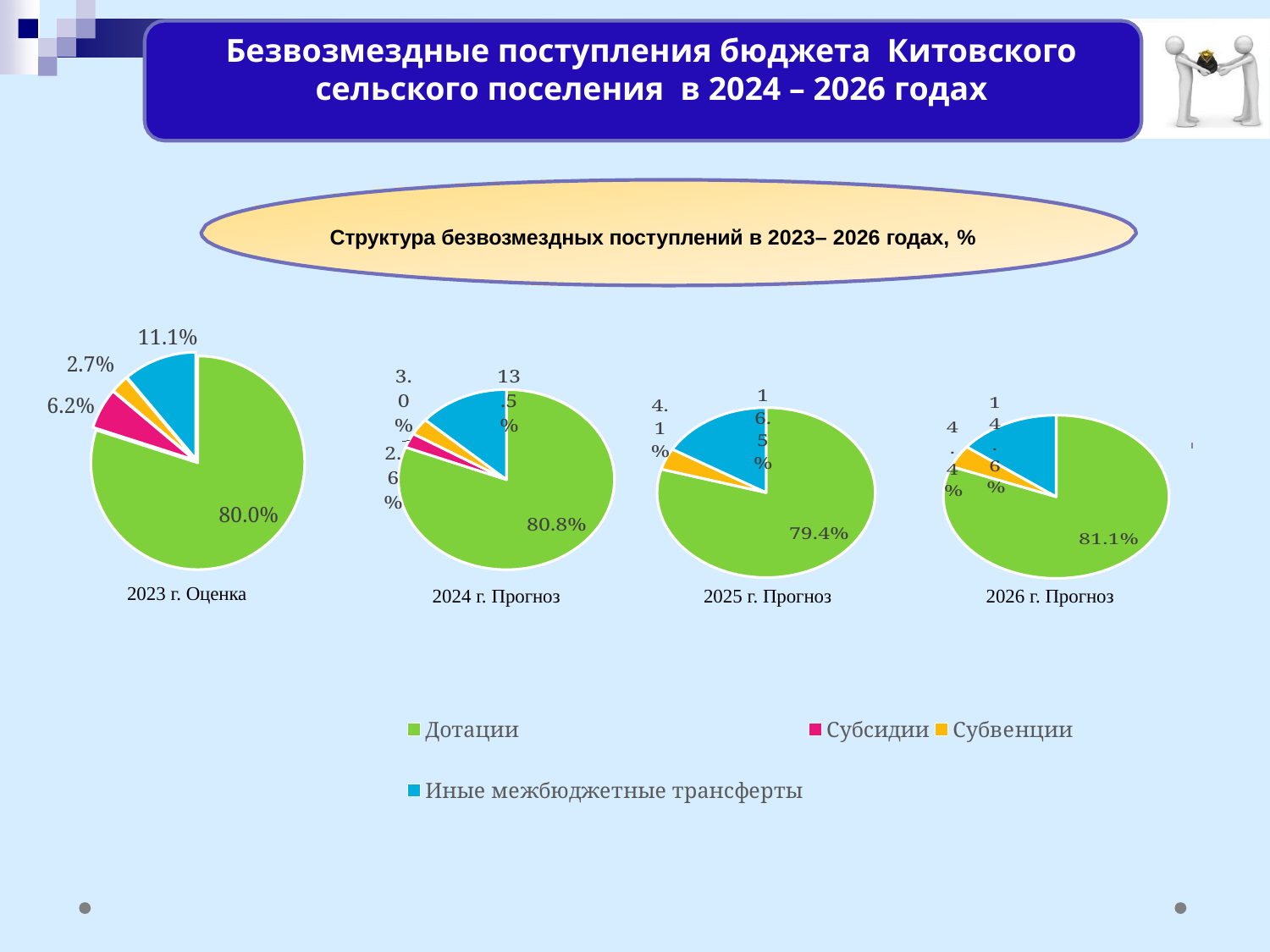
In the 2026 г. Прогноз pie chart, what is the value for Дотации? 81.1% In the 2023 г. Оценка pie chart, which category has the smallest share? Субвенции In the 2023 г. Оценка pie chart, which category has the largest share? Дотации In the 2023 г. Оценка pie chart, what is the value for Иные межбюджетные трансферты? 11.1% In the 2023 г. Оценка pie chart, what is the value for Субсидии? 6.2% In the 2024 г. Прогноз pie chart, what is the value for Дотации? 80.8% In the 2023 г. Оценка pie chart, what is the value for Дотации? 80.0% In the 2025 г. Прогноз pie chart, what is the value for Дотации? 79.4% How many series does the legend list for the charts on this slide? 4 Which is larger: the Дотации share in the 2025 г. Прогноз chart or in the 2026 г. Прогноз chart? 2026 г. Прогноз In the 2023 г. Оценка pie chart, what is the difference between the Дотации share and the Иные межбюджетные трансферты share? 68.9 percentage points In the 2023 г. Оценка pie chart, what is the value for Субвенции? 2.7%